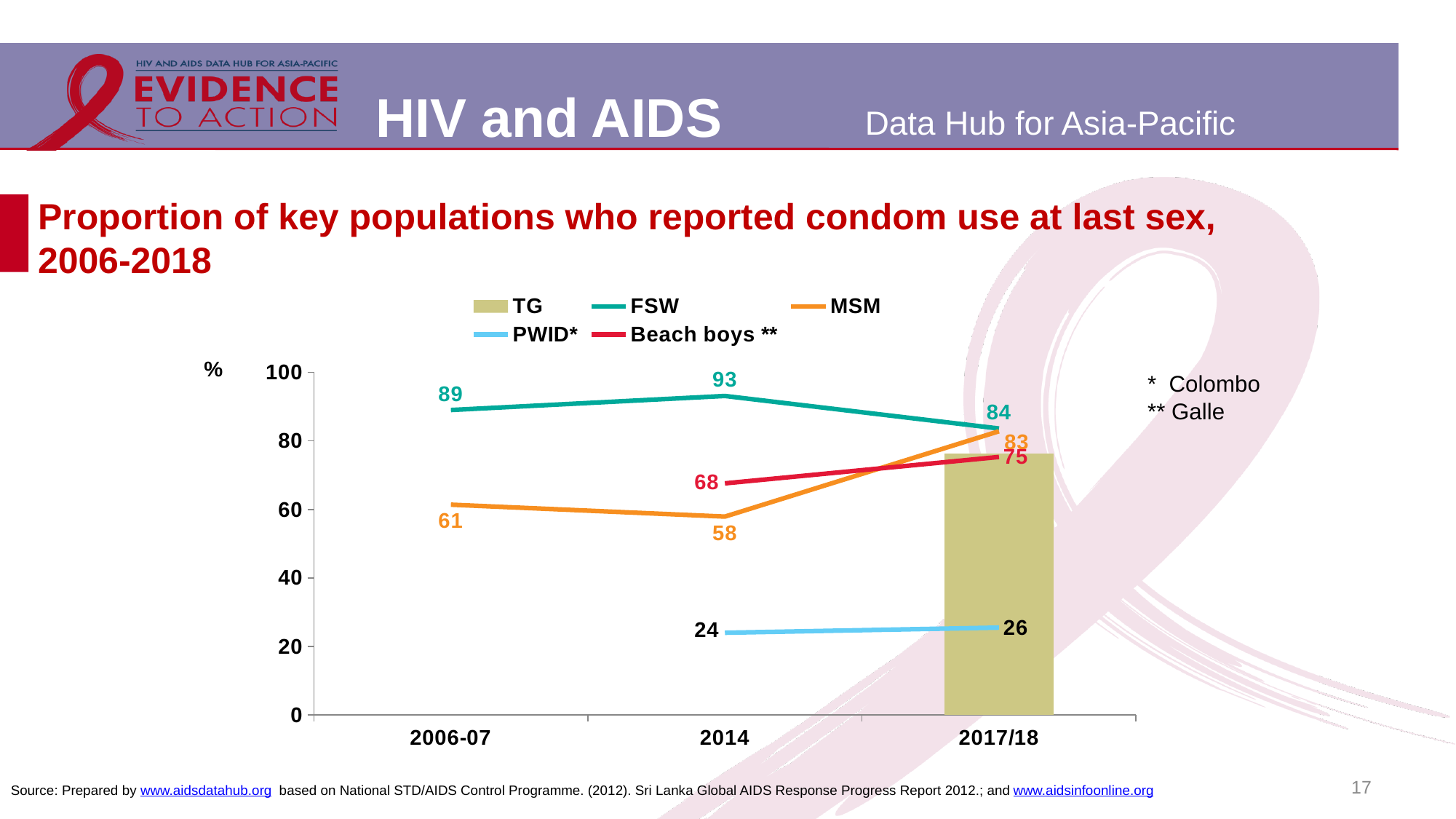
How many time periods are shown on the x axis? 3 Which was larger in 2017/18, the MSM value or the Beach boys ** value? MSM By how many percentage points did the MSM value change from 2014 to 2017/18? 25 Did the FSW value rise or fall between 2014 and 2017/18? fall Is the TG bar value for 2017/18 greater or less than 60? greater Which key population had the lowest value in 2014? PWID* How many series does the legend list? 5 What was the FSW value in 2014? 93 Which key population had the highest value in 2017/18? FSW What was the MSM value in 2006-07? 61 What was the PWID* value in 2017/18? 26 What was the Beach boys ** value in 2014? 68